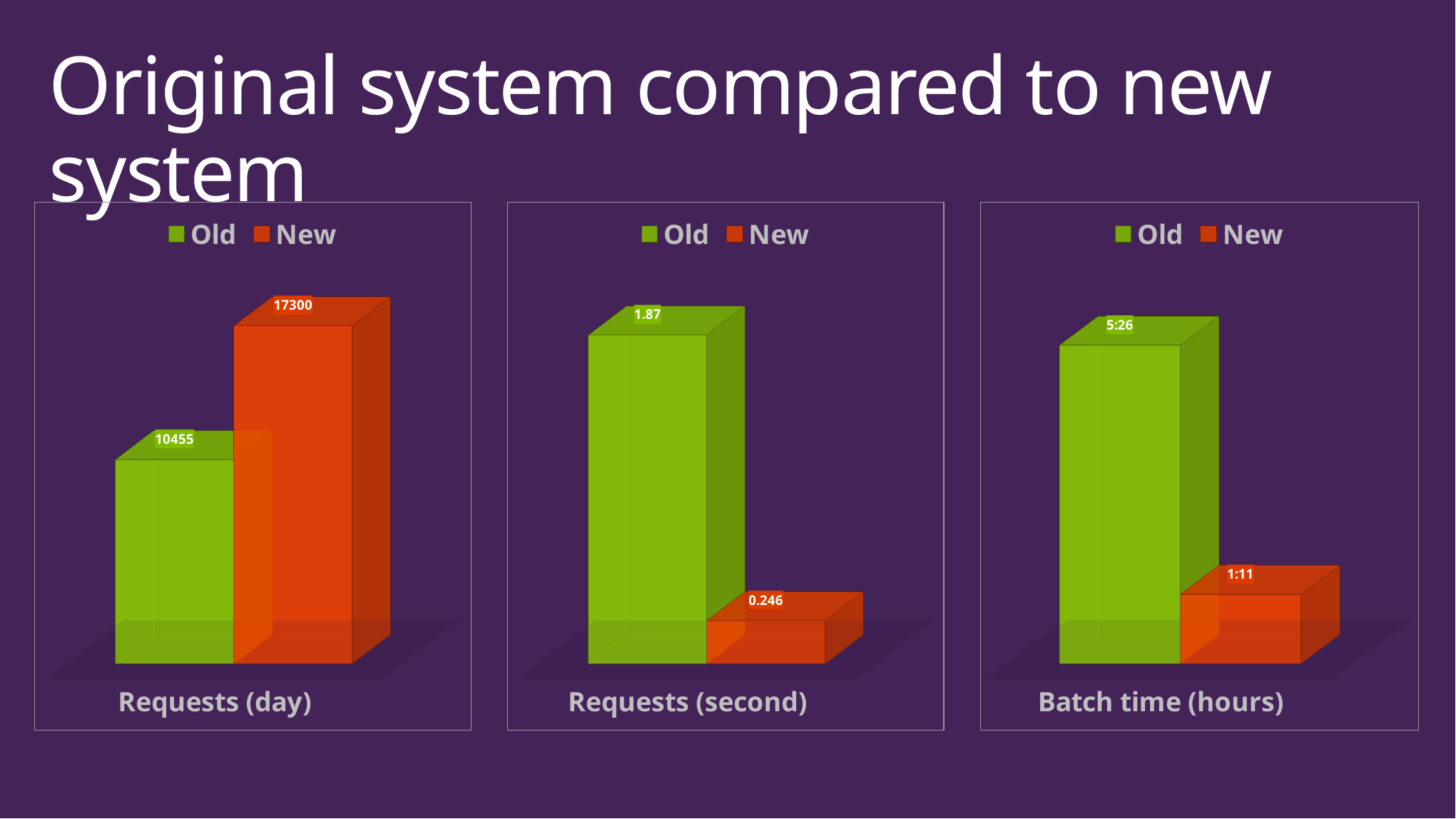
How many series does the legend of the Requests (second) chart list? 2 In the Requests (second) chart, what is the value for New? 0.246 In the Requests (day) chart, what is the value for New? 17300 In the Batch time (hours) chart, which series has the higher value? Old In the Batch time (hours) chart, what is the value for New? 1:11 In the Batch time (hours) chart, what is the value for Old? 5:26 In the Requests (day) chart, what is the difference between the New and Old values? 6845 In the Requests (second) chart, which series has the lower value? New In the Requests (second) chart, what is the value for Old? 1.87 In the Requests (day) chart, which series has the higher value, Old or New? New What type of chart is the Batch time (hours) chart? Bar chart In the Requests (day) chart, what is the value for Old? 10455